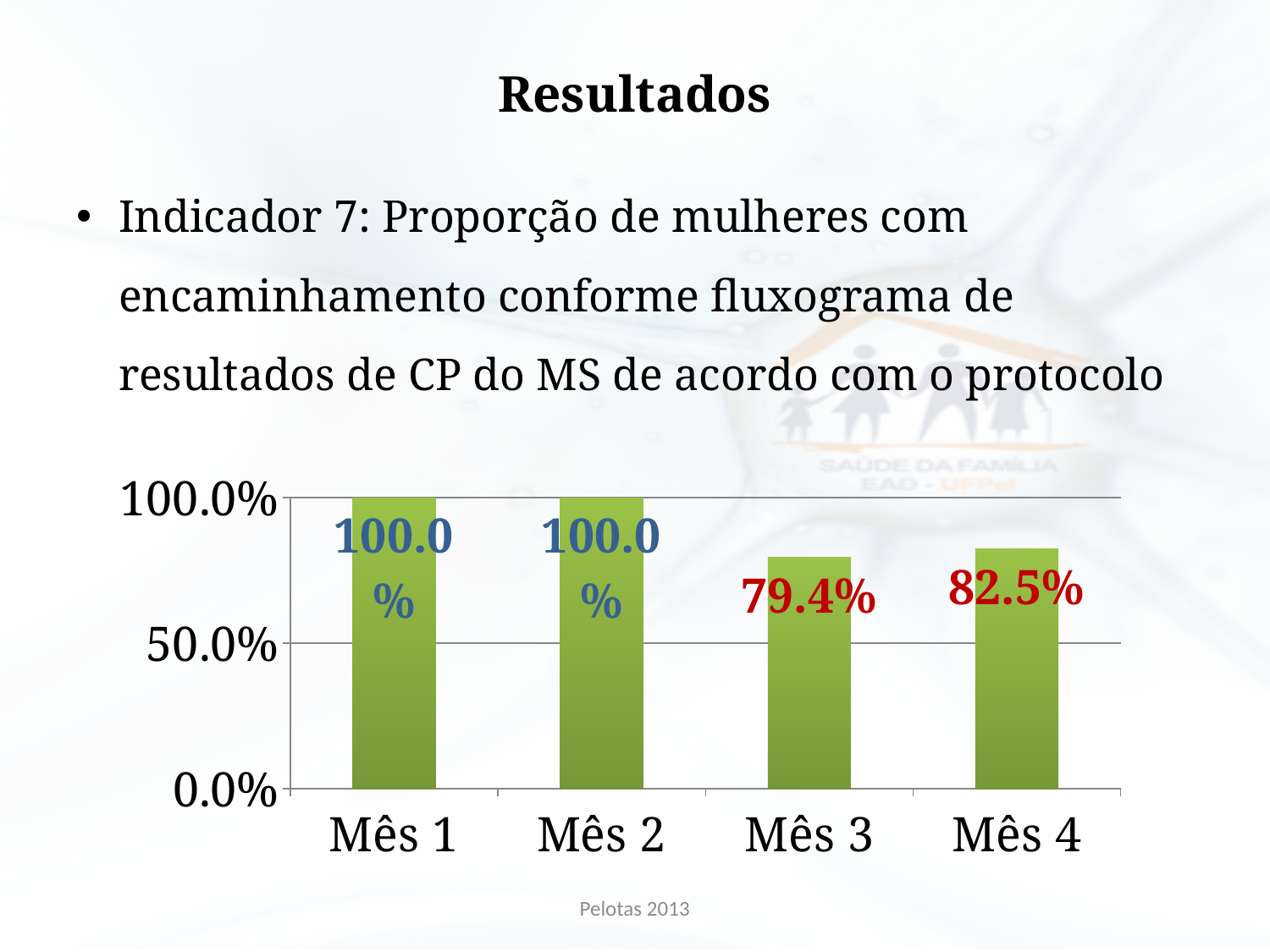
What is the difference between the values for Mês 4 and Mês 3? 3.1% Which is larger, the value for Mês 3 or the value for Mês 4? Mês 4 What is the value for Mês 4? 82.5% What is the difference between the values for Mês 1 and Mês 3? 20.6% Which month has the lowest value? Mês 3 Do the values rise or fall from Mês 2 to Mês 3? fall What colour are the bars in the chart? green How many months are shown on the x axis? 4 What is the value for Mês 3? 79.4% Is the value for Mês 3 greater or less than 50.0%? greater What kind of chart is shown on the slide? bar chart What is the value for Mês 1? 100.0%